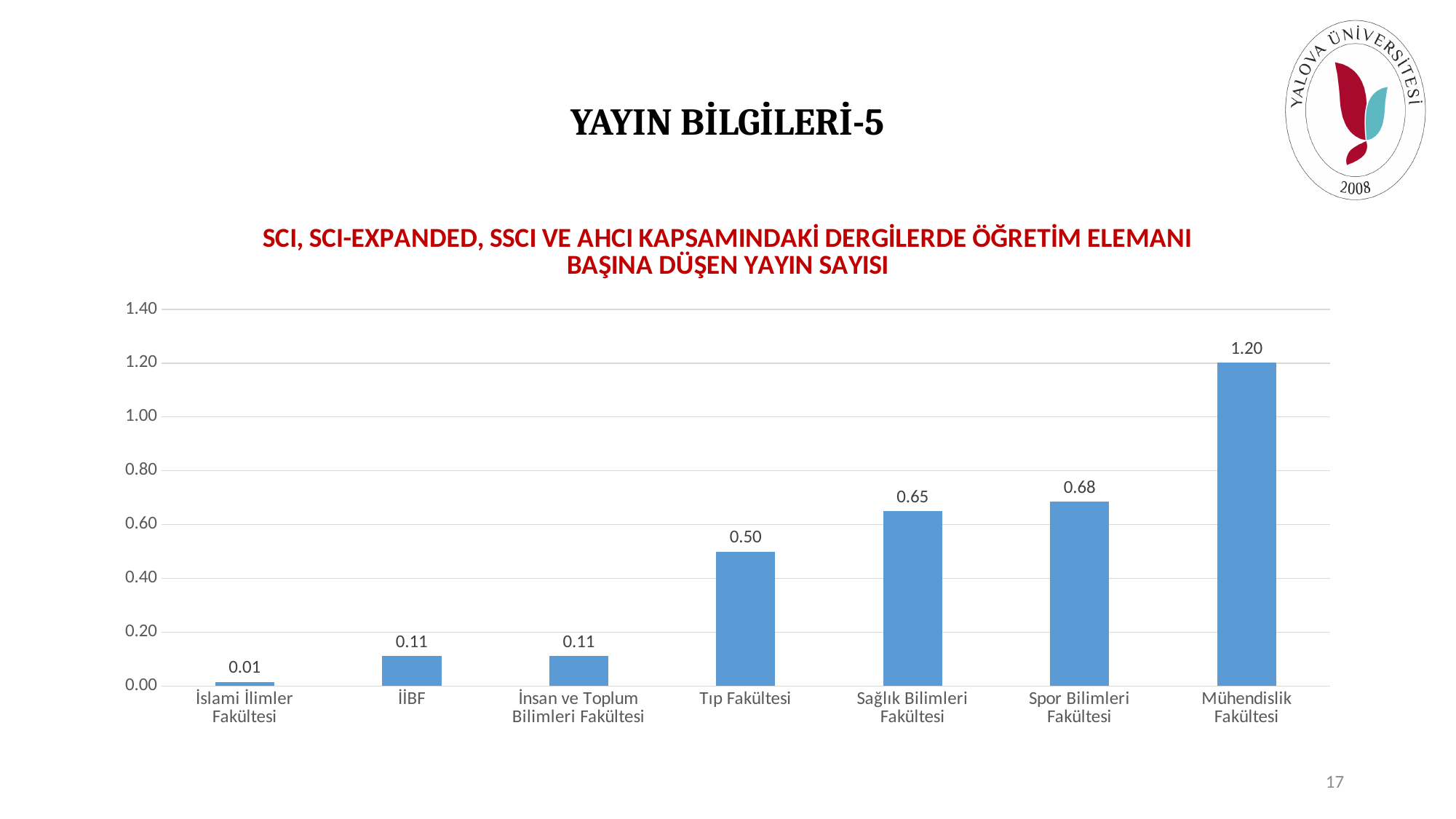
Is the value for Mühendislik Fakültesi greater or less than 1.00? greater How many faculties are shown on the chart? 7 Do the values generally rise or fall from left to right along the x axis? Rise What is the value for Mühendislik Fakültesi? 1.20 Which faculty has the highest value? Mühendislik Fakültesi Which is larger, the value for Spor Bilimleri Fakültesi or the value for Tıp Fakültesi? Spor Bilimleri Fakültesi What is the difference between the values for Sağlık Bilimleri Fakültesi and Tıp Fakültesi? 0.15 What is the difference between the values for Mühendislik Fakültesi and Spor Bilimleri Fakültesi? 0.52 What is the value for Sağlık Bilimleri Fakültesi? 0.65 Which faculty has the lowest value? İslami İlimler Fakültesi What kind of chart is shown on the slide? Bar chart What is the value for Tıp Fakültesi? 0.50